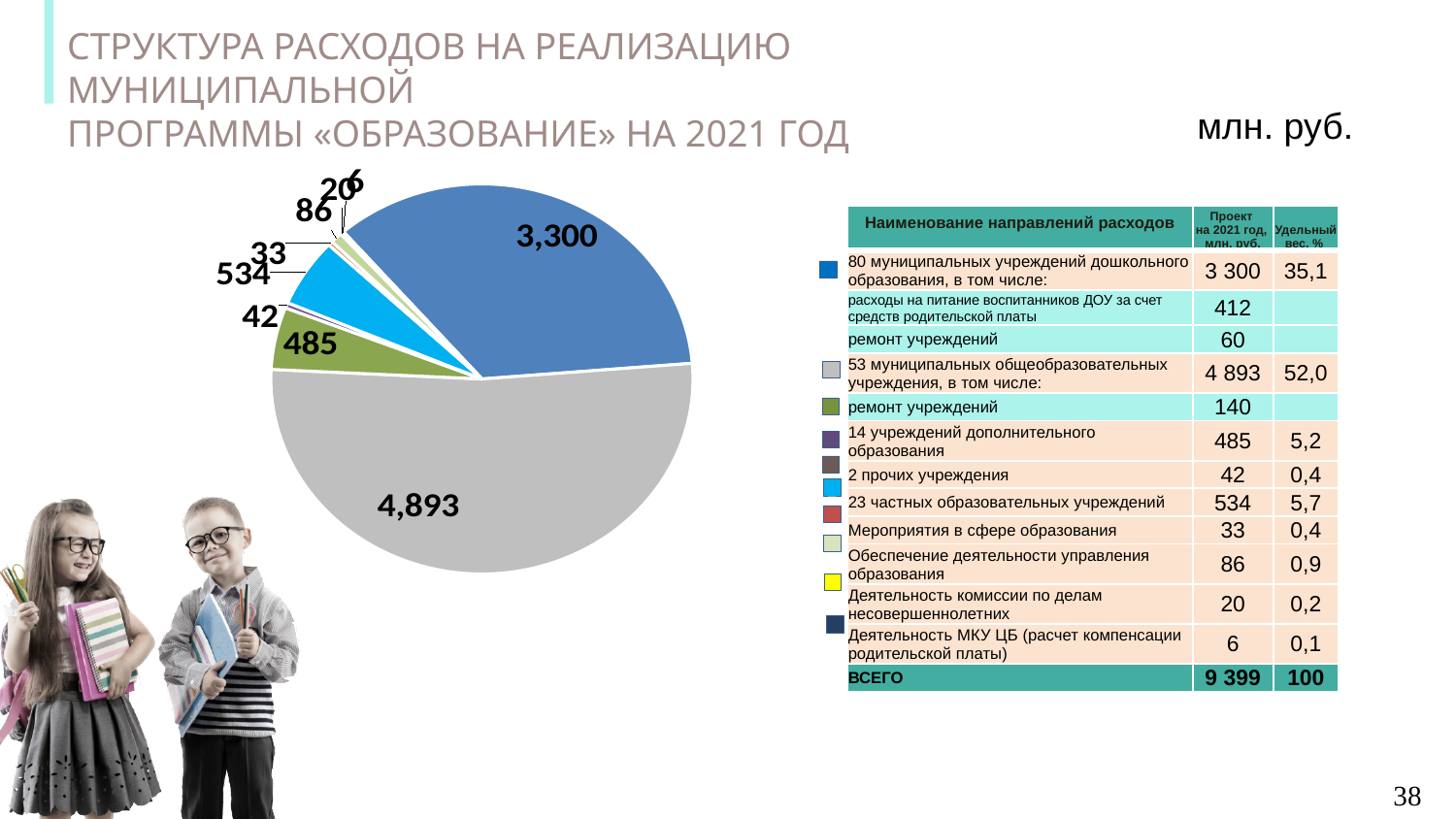
Which slice is larger: the one labelled 534 or the one labelled 485? 534 What is the value shown on the blue slice of the pie chart? 3,300 What kind of chart is shown on the slide? pie chart In what units are the pie chart values expressed, according to the slide? млн. руб. How many slices are labelled in the pie chart? 9 What is the difference between the two largest slices, 4,893 and 3,300? 1,593 What is the difference between the slices labelled 86 and 42? 44 According to the table, what share of the total does the 4,893 slice (53 municipal general education institutions) represent? 52,0% What is the value of the largest slice in the pie chart? 4,893 What is the value shown on the green slice of the pie chart? 485 What is the value shown on the gray slice of the pie chart? 4,893 What is the value of the smallest slice in the pie chart? 6